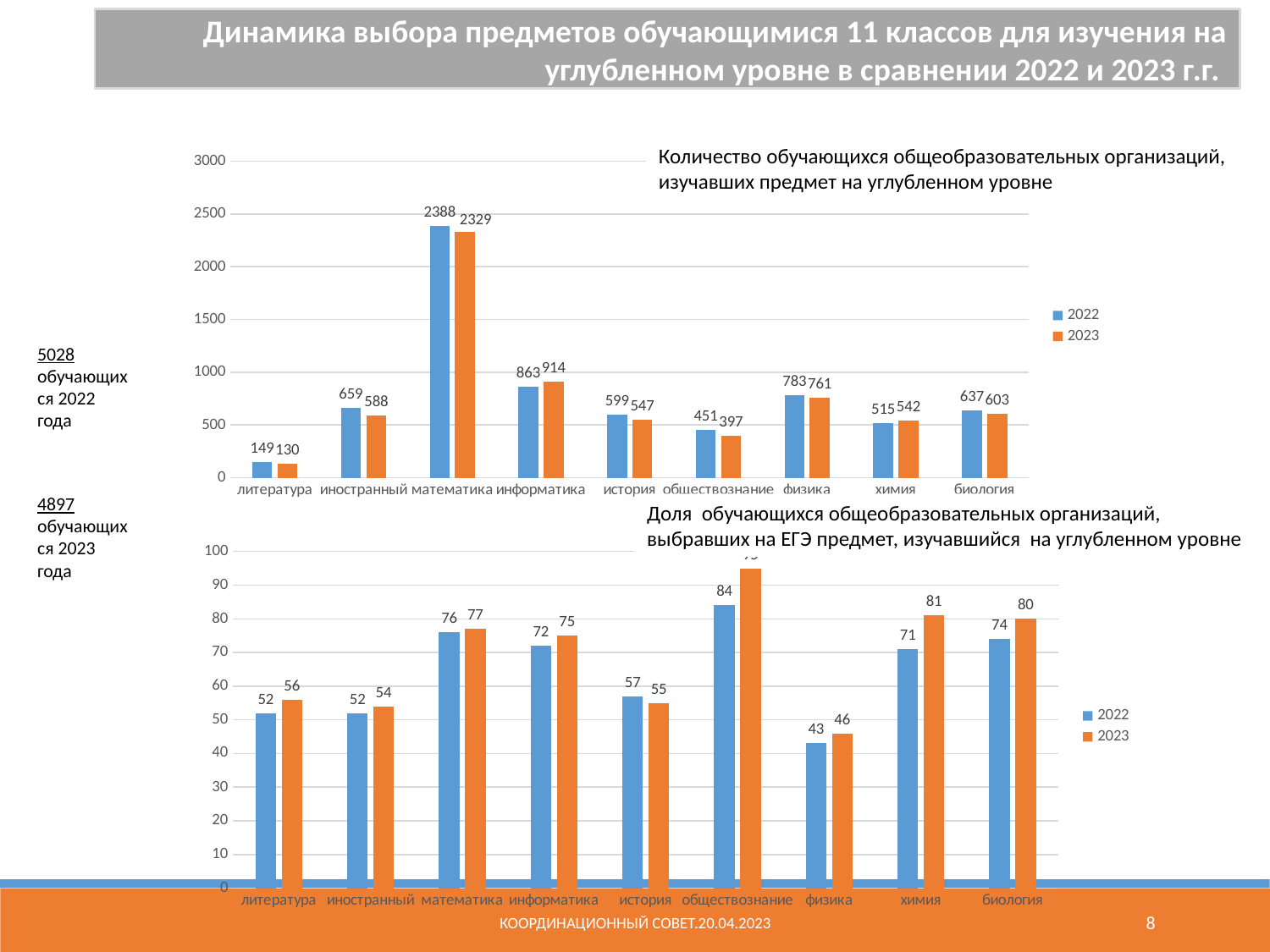
In the bottom chart (Доля обучающихся...), what is the difference between the 2023 and 2022 values for биология? 6 In the top chart (Количество обучающихся...), which is larger for химия: the 2022 value or the 2023 value? 2023 In the top chart (Количество обучающихся...), what is the value for математика in 2022? 2388 In the bottom chart (Доля обучающихся...), which subject has the lowest value in 2022? физика In the top chart (Количество обучающихся...), how many subjects are shown on the x axis? 9 In the bottom chart (Доля обучающихся...), what is the value for химия in 2023? 81 In the top chart (Количество обучающихся...), which subject has the lowest value in 2022? литература In the top chart (Количество обучающихся...), what is the value for информатика in 2023? 914 In the bottom chart (Доля обучающихся...), how many series does the legend list? 2 What type of chart is the bottom chart (Доля обучающихся...)? bar chart In the top chart (Количество обучающихся...), what is the difference between the 2022 and 2023 values for физика? 22 In the top chart (Количество обучающихся...), which subject has the highest value in 2023? математика